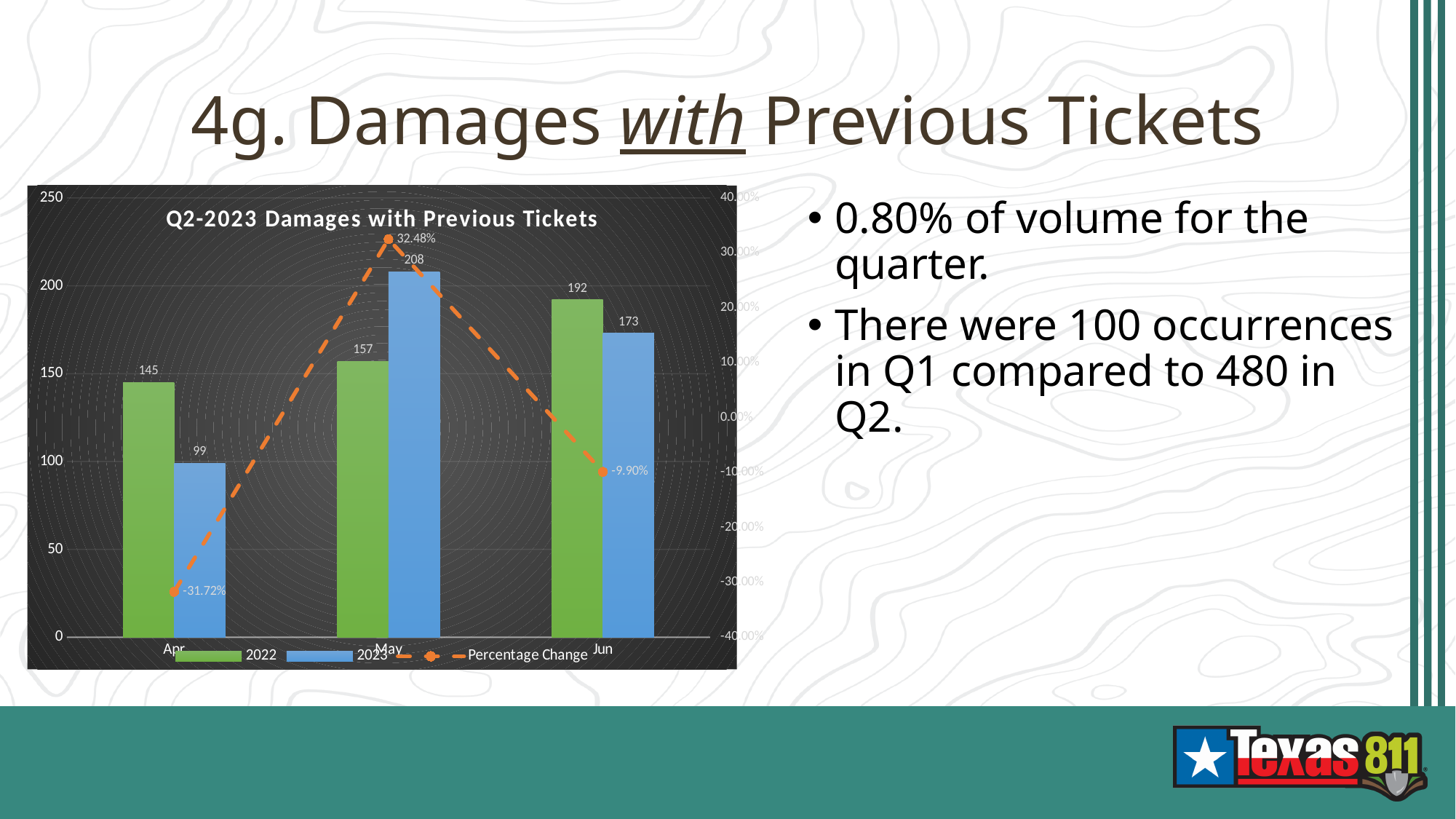
Do the 2023 values rise or fall from Apr to May? rise Which month has the lowest 2022 value? Apr What is the 2023 value for May? 208 How many months are shown on the x axis? 3 What is the Percentage Change value for Apr? -31.72% What is the 2022 value for Apr? 145 What is the Percentage Change value for Jun? -9.90% What is the title of the chart? Q2-2023 Damages with Previous Tickets How many series does the legend list? 3 Which is larger for Jun, the 2022 value or the 2023 value? 2022 Which month has the highest 2023 value? May What is the difference between the 2022 and 2023 values for Apr? 46